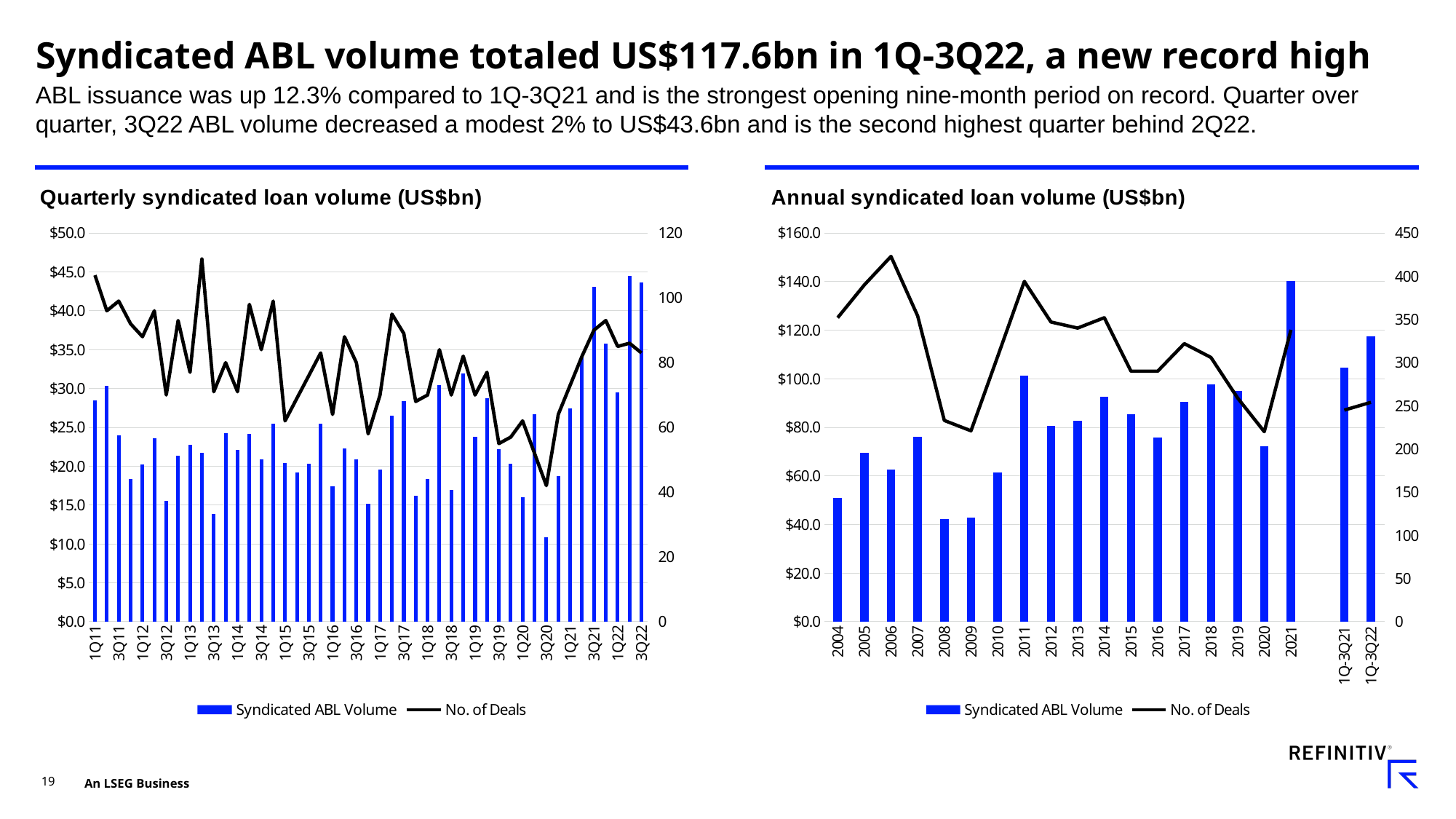
On the Annual syndicated loan volume chart, which year has the highest Syndicated ABL Volume bar? 2021 On the Quarterly syndicated loan volume chart, which quarter has the highest Syndicated ABL Volume bar? 2Q22 On the Quarterly syndicated loan volume chart, which is larger, the Syndicated ABL Volume for 3Q21 or for 1Q22? 3Q21 On the Annual syndicated loan volume chart, is the Syndicated ABL Volume for 2008 greater or less than $60.0? less On the Annual syndicated loan volume chart, how many categories are shown on the x axis? 20 On the Quarterly syndicated loan volume chart, which quarter has the lowest Syndicated ABL Volume bar? 3Q20 On the Quarterly syndicated loan volume chart, is the Syndicated ABL Volume for 3Q21 greater or less than $40.0? greater On the Annual syndicated loan volume chart, is the Syndicated ABL Volume for 2021 greater or less than $120.0? greater On the Annual syndicated loan volume chart, does the No. of Deals line rise or fall from 2004 to 2006? rise On the Quarterly syndicated loan volume chart, how many series does the legend list? 2 On the Annual syndicated loan volume chart, which is larger, the Syndicated ABL Volume for 2007 or for 2008? 2007